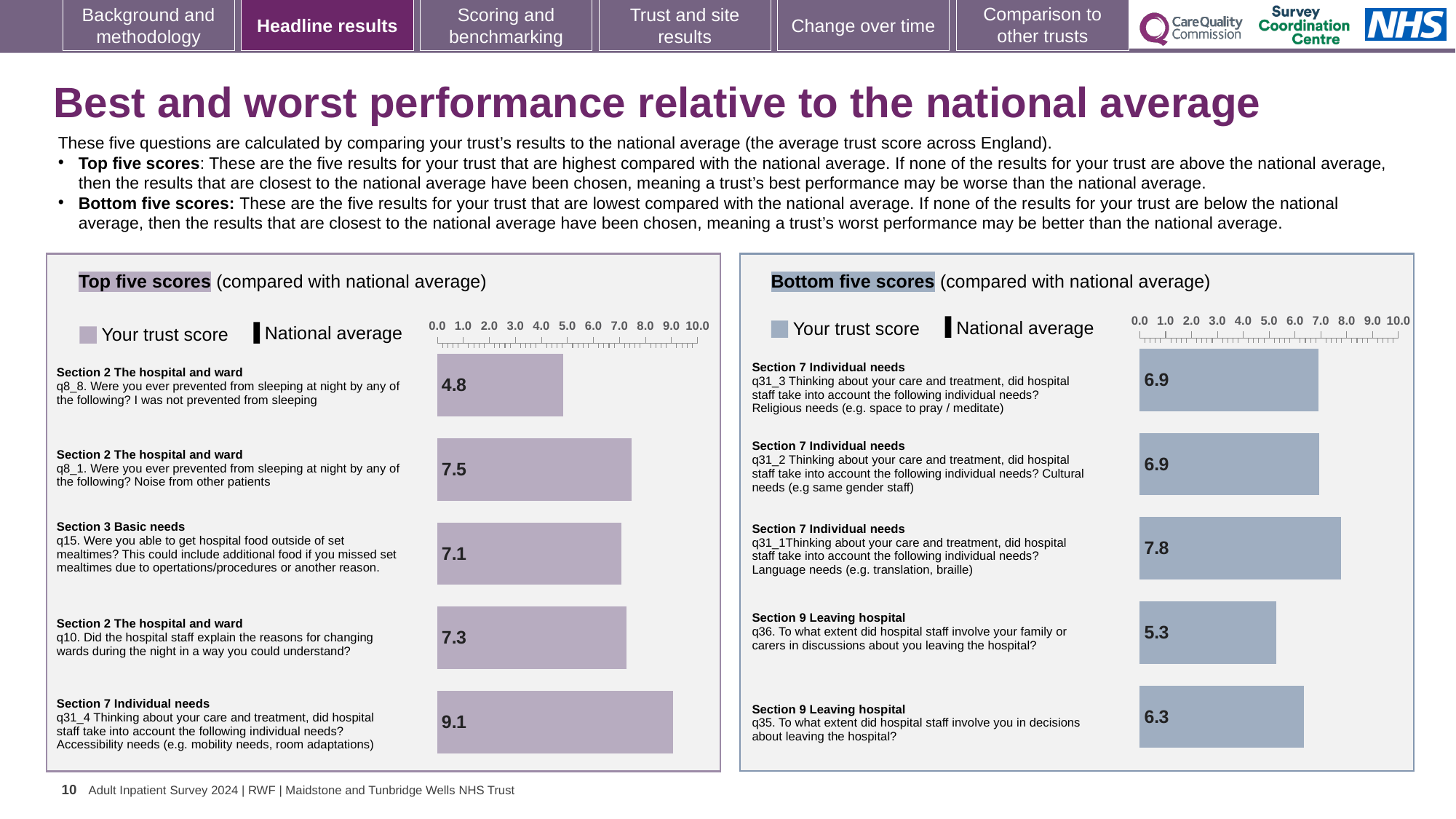
In the 'Top five scores' chart, which has the larger trust score: q8_1 (Noise from other patients) or q15 (food outside set mealtimes)? q8_1 (Noise from other patients) How many series does the legend of the 'Bottom five scores' chart list? 2 In the 'Top five scores' chart, what is the trust score for q8_8 (I was not prevented from sleeping)? 4.8 In the 'Bottom five scores' chart, what is the difference between the trust scores for q31_1 and q35? 1.5 How many questions are plotted in the 'Bottom five scores' chart? 5 In the 'Bottom five scores' chart, what is the trust score for q31_1 (Language needs)? 7.8 What kind of chart is the 'Top five scores' chart? Bar chart In the 'Bottom five scores' chart, what is the trust score for q36 (involving family or carers in discussions about leaving hospital)? 5.3 In the 'Bottom five scores' chart, which question has the lowest trust score? q36 (involving family or carers in discussions about leaving hospital) In the 'Top five scores' chart, what is the trust score for q31_4 (Accessibility needs)? 9.1 In the 'Top five scores' chart, what is the difference between the trust scores for q31_4 and q8_8? 4.3 In the 'Top five scores' chart, which question has the highest trust score? q31_4 (Accessibility needs)